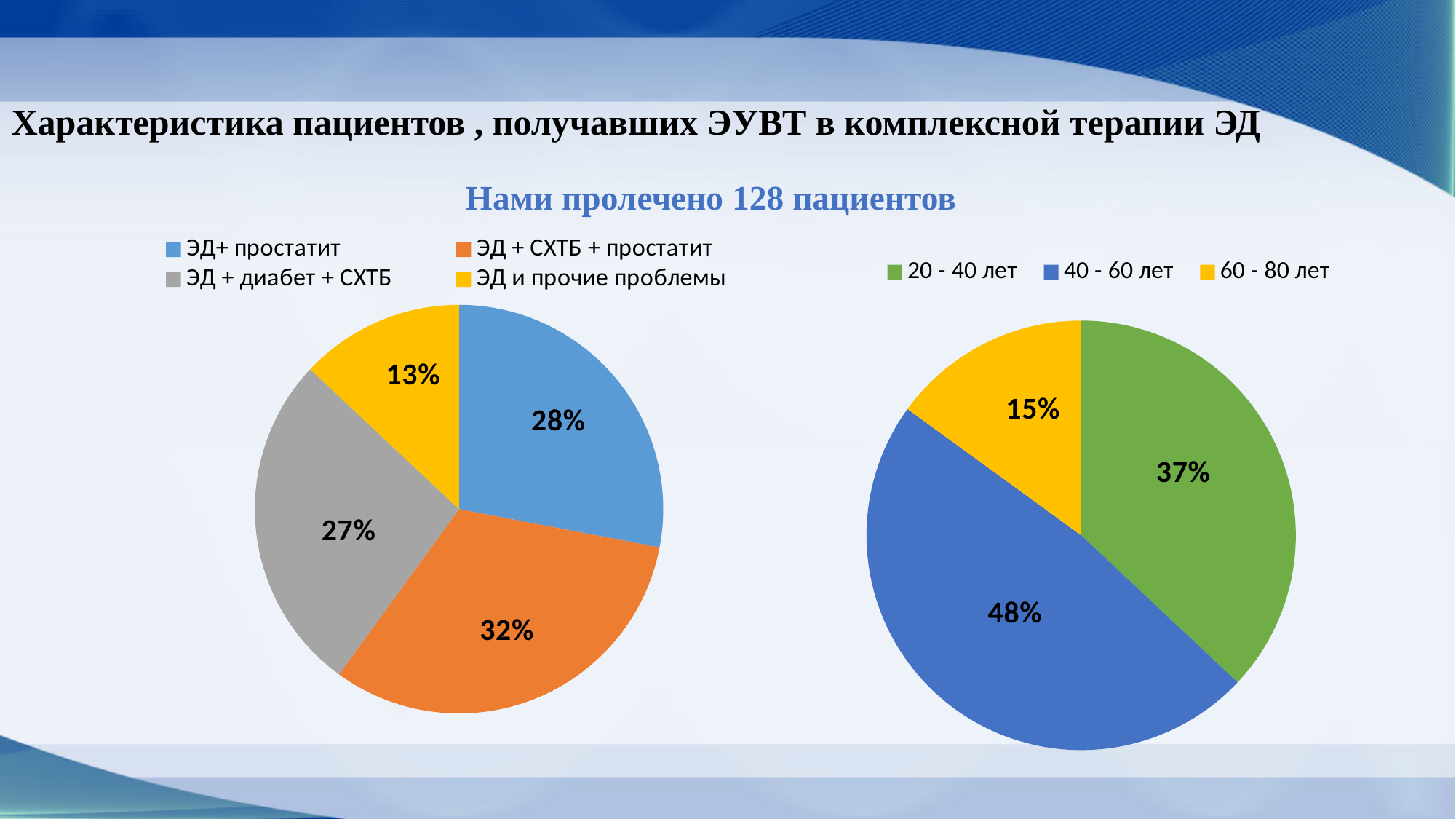
In the left pie chart, which is larger: ЭД+ простатит or ЭД + диабет + СХТБ? ЭД+ простатит In the left pie chart, which category has the largest slice? ЭД + СХТБ + простатит In the right pie chart, which age group has the smallest slice? 60 - 80 лет In the left pie chart, what share is labelled for ЭД и прочие проблемы? 13% How many slices does the left pie chart have? 4 What type of chart is shown on the right side of the slide? Pie chart In the left pie chart, what share is labelled for ЭД + СХТБ + простатит? 32% In the left pie chart, which category has the smallest slice? ЭД и прочие проблемы How many entries does the legend of the right chart list? 3 In the right pie chart, what is the difference in percentage points between 40 - 60 лет and 60 - 80 лет? 33 In the right pie chart, what share is labelled for 20 - 40 лет? 37% In the right pie chart, what share is labelled for 40 - 60 лет? 48%